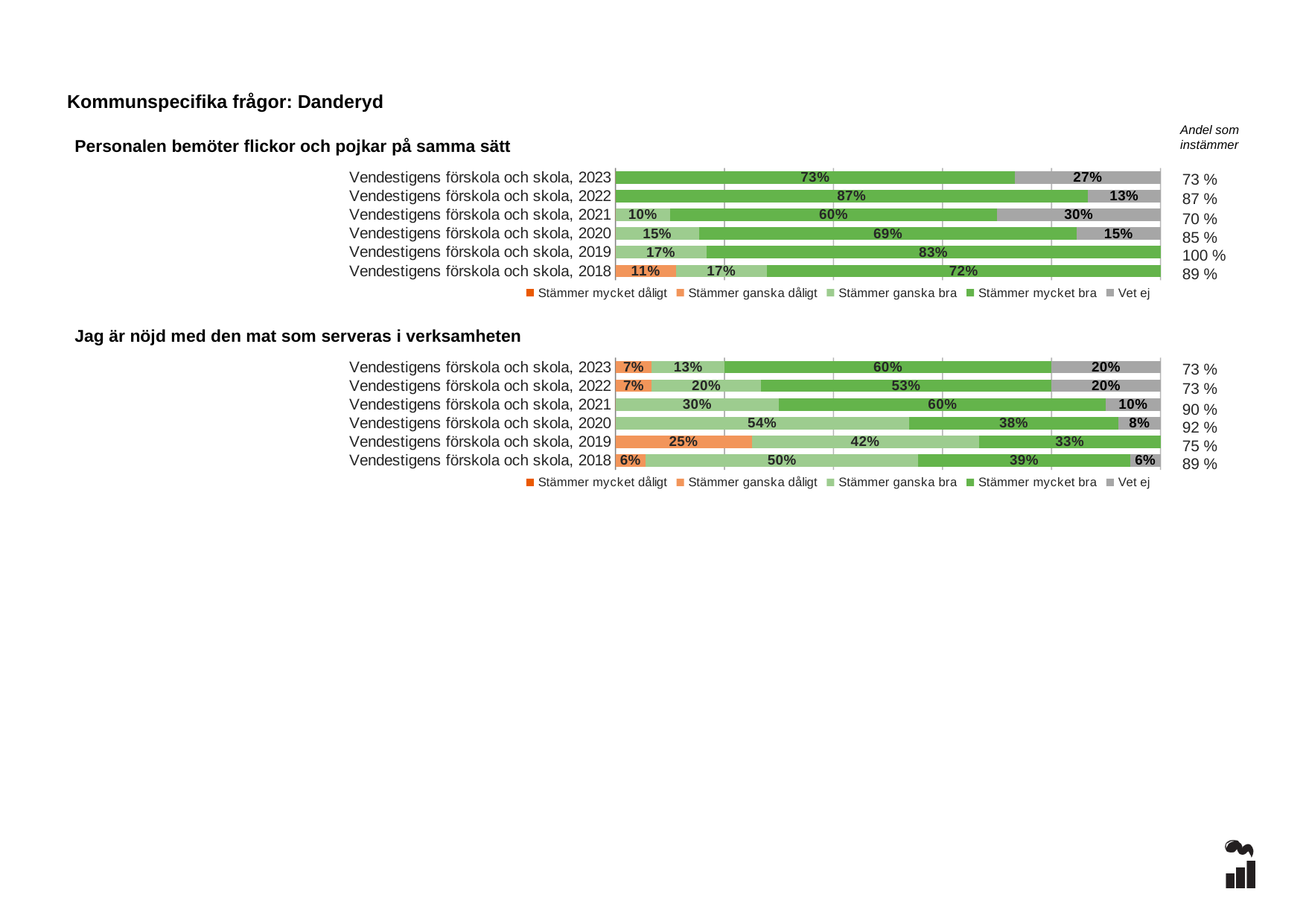
In the chart 'Personalen bemöter flickor och pojkar på samma sätt', how many bars (years) are shown? 6 In the chart 'Jag är nöjd med den mat som serveras i verksamheten', what is the 'Stämmer ganska dåligt' value for Vendestigens förskola och skola, 2019? 25% In the chart 'Jag är nöjd med den mat som serveras i verksamheten', is the 'Stämmer mycket bra' value larger for 2021 or for 2022? 2021 In the chart 'Jag är nöjd med den mat som serveras i verksamheten', what is the 'Stämmer ganska bra' value for Vendestigens förskola och skola, 2020? 54% What kind of chart is 'Personalen bemöter flickor och pojkar på samma sätt'? Stacked bar chart How many series does the legend of the chart 'Jag är nöjd med den mat som serveras i verksamheten' list? 5 In the chart 'Personalen bemöter flickor och pojkar på samma sätt', which year has the highest 'Stämmer mycket bra' value? Vendestigens förskola och skola, 2022 In the chart 'Personalen bemöter flickor och pojkar på samma sätt', what is the 'Vet ej' value for Vendestigens förskola och skola, 2021? 30% In the chart 'Jag är nöjd med den mat som serveras i verksamheten', what is the 'Andel som instämmer' for Vendestigens förskola och skola, 2020? 92 % In the chart 'Personalen bemöter flickor och pojkar på samma sätt', what is the difference between the 'Stämmer mycket bra' values for 2022 and 2023? 14% In the chart 'Personalen bemöter flickor och pojkar på samma sätt', what is the 'Stämmer mycket bra' value for Vendestigens förskola och skola, 2022? 87% In the chart 'Jag är nöjd med den mat som serveras i verksamheten', which year has the lowest 'Stämmer mycket bra' value? Vendestigens förskola och skola, 2019